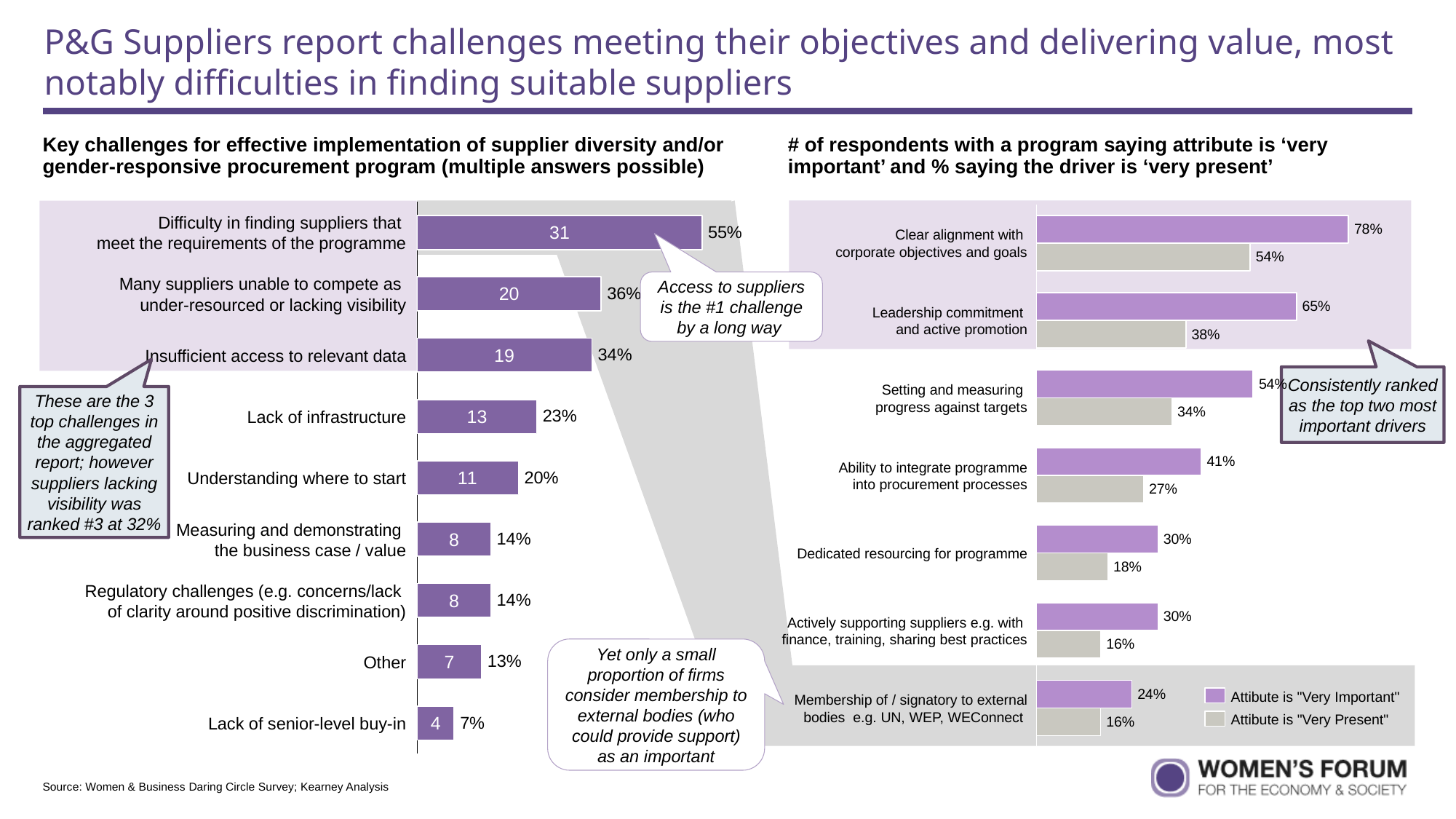
What kind of chart is the left chart on key challenges? Bar chart In the left chart on key challenges, what is the difference in respondent count between 'Many suppliers unable to compete as under-resourced or lacking visibility' and 'Insufficient access to relevant data'? 1 In the right chart on drivers, which is larger for 'Setting and measuring progress against targets': the 'Very Important' or the 'Very Present' percentage? Very Important In the left chart on key challenges, how many respondents cited 'Difficulty in finding suppliers that meet the requirements of the programme'? 31 In the left chart on key challenges, how many challenge categories are plotted? 9 In the right chart on drivers, how many series does the legend list? 2 In the right chart on drivers, which attribute has the highest 'Very Important' percentage? Clear alignment with corporate objectives and goals In the left chart on key challenges, what percentage is shown for 'Lack of infrastructure'? 23% In the right chart on drivers, what percentage of respondents said 'Clear alignment with corporate objectives and goals' is 'Very Important'? 78% In the right chart on drivers, what percentage said 'Leadership commitment and active promotion' is 'Very Present'? 38% In the right chart on drivers, what is the difference between the 'Very Important' and 'Very Present' percentages for 'Dedicated resourcing for programme'? 12% In the left chart on key challenges, which challenge has the lowest value? Lack of senior-level buy-in